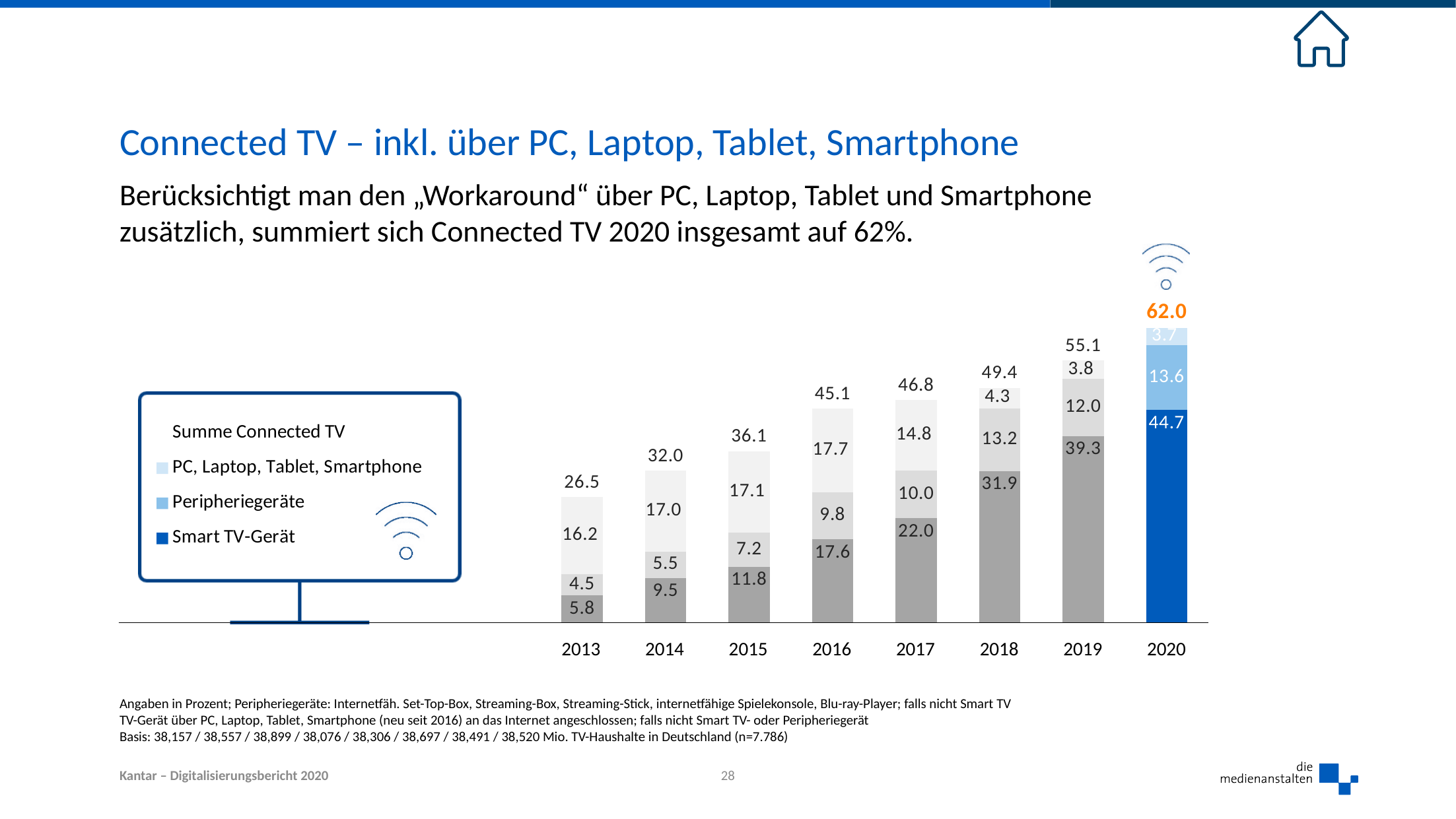
What is the Peripheriegeräte value for 2019? 12.0 What is the PC, Laptop, Tablet, Smartphone value for 2018? 4.3 What is the Smart TV-Gerät value for 2020? 44.7 What is the total Connected TV value (Summe Connected TV) for 2020? 62.0 What is the difference between the total Connected TV values for 2020 and 2019? 6.9 How many years are shown on the x axis of the chart? 8 Do the total Connected TV values rise or fall from 2013 to 2020? rise Is the Smart TV-Gerät value larger in 2017 or in 2018? 2018 What is the Smart TV-Gerät value for 2013? 5.8 Which year has the highest total Connected TV value? 2020 What type of chart is shown on the slide? stacked bar chart Which year has the lowest total Connected TV value? 2013